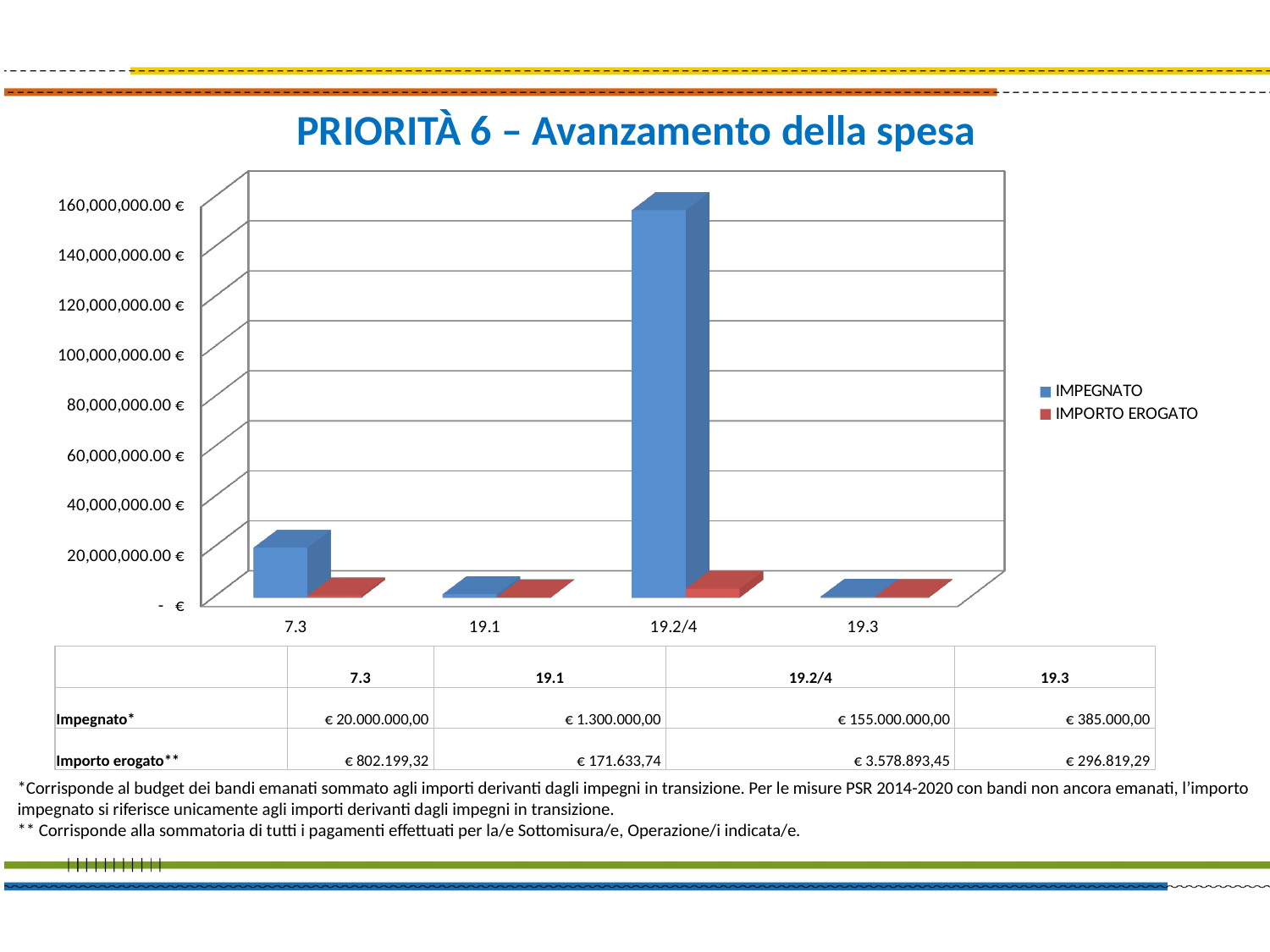
Is the IMPEGNATO value for 19.2/4 greater or less than 140,000,000.00 €? greater What is the IMPORTO EROGATO value for 7.3? € 802.199,32 What kind of chart is shown on the slide? Bar chart How many categories are shown on the x axis? 4 What is the IMPEGNATO value for 19.1? € 1.300.000,00 Which category has the lowest IMPORTO EROGATO value? 19.1 What is the IMPORTO EROGATO value for 19.3? € 296.819,29 What is the difference between IMPEGNATO and IMPORTO EROGATO for 7.3? € 19.197.800,68 What is the IMPEGNATO value for 19.2/4? € 155.000.000,00 Is the IMPEGNATO value for 7.3 larger than the IMPEGNATO value for 19.3? Yes How many series does the legend list? 2 Which category has the highest IMPEGNATO value? 19.2/4